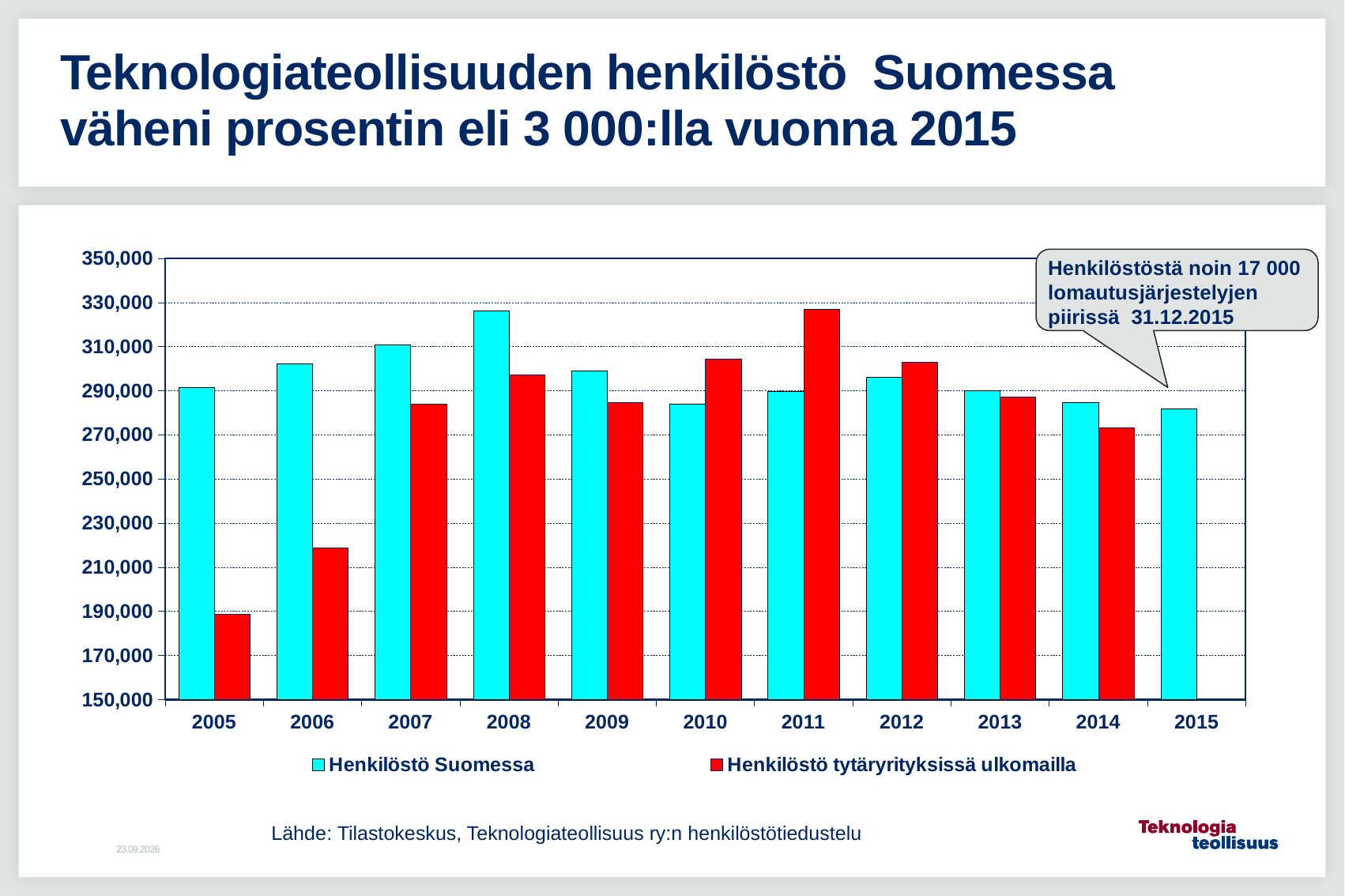
How many years are shown on the x axis? 11 Is the value for Henkilöstö tytäryrityksissä ulkomailla in 2005 greater or less than 210,000? less In 2011, which series has the larger value: Henkilöstö Suomessa or Henkilöstö tytäryrityksissä ulkomailla? Henkilöstö tytäryrityksissä ulkomailla How many series does the legend list? 2 In 2005, which series has the larger value: Henkilöstö Suomessa or Henkilöstö tytäryrityksissä ulkomailla? Henkilöstö Suomessa In which year is the value for Henkilöstö Suomessa highest? 2008 In which year is the value for Henkilöstö tytäryrityksissä ulkomailla highest? 2011 Does the value for Henkilöstö Suomessa rise or fall from 2012 to 2015? fall What kind of chart is shown on the slide? bar chart Is the value for Henkilöstö Suomessa in 2015 greater or less than 290,000? less Is the value for Henkilöstö Suomessa in 2008 greater or less than 310,000? greater In which year is the value for Henkilöstö tytäryrityksissä ulkomailla lowest? 2005